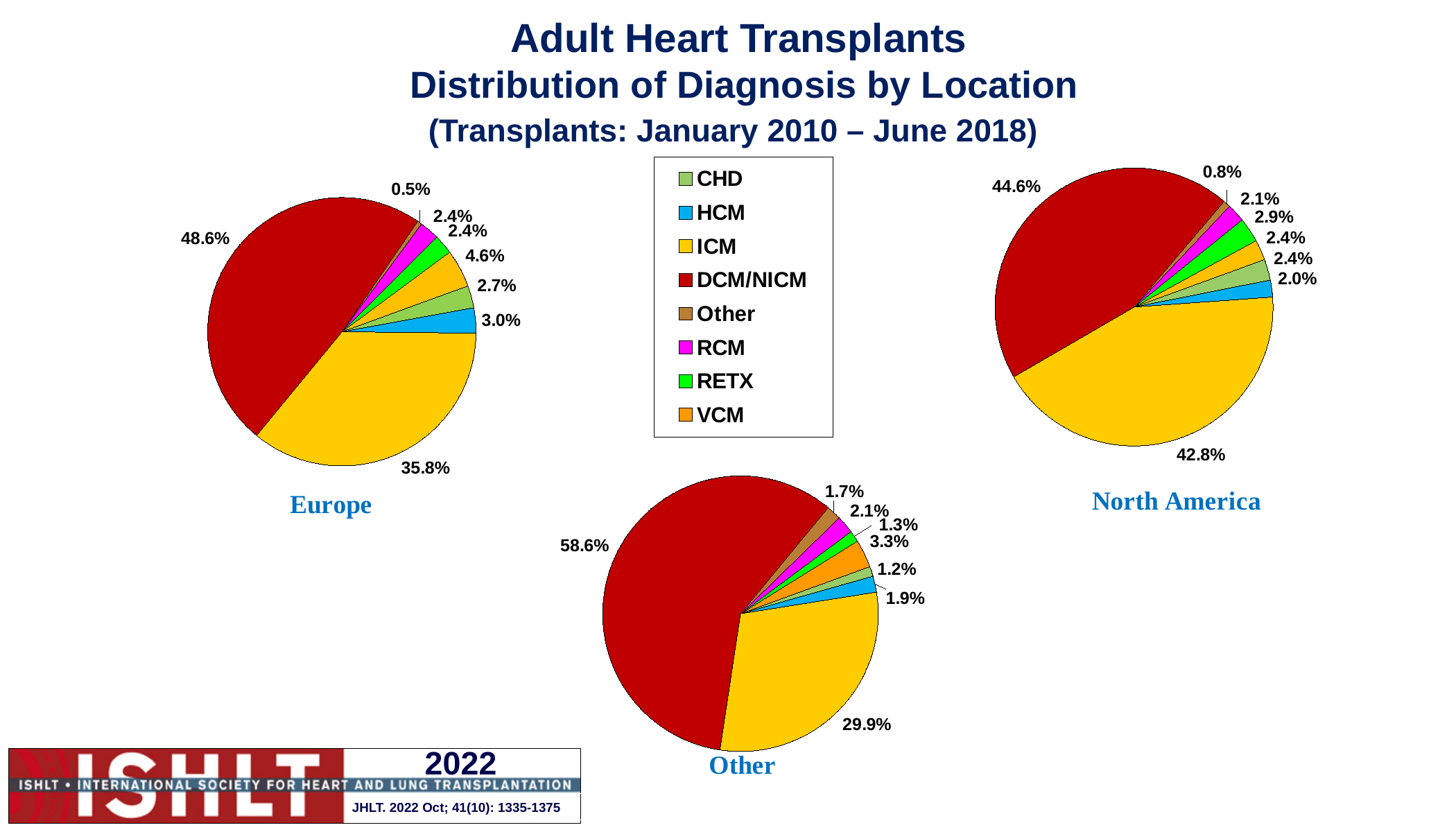
In the Europe pie chart, what share is ICM? 35.8% In the Europe pie chart, which diagnosis has the largest share? DCM/NICM In the Europe pie chart, what share is DCM/NICM? 48.6% In the North America pie chart, what share is ICM? 42.8% How many diagnosis categories does the legend list? 8 In the Other pie chart, what share is ICM? 29.9% In the Europe pie chart, which diagnosis has the smallest share? Other In the North America pie chart, what share is DCM/NICM? 44.6% In the North America pie chart, which is larger, the DCM/NICM share or the ICM share? DCM/NICM In the Other pie chart, what share is DCM/NICM? 58.6% What kind of charts are shown on the slide? Pie charts In the Other pie chart, what is the difference between the DCM/NICM share and the ICM share? 28.7%